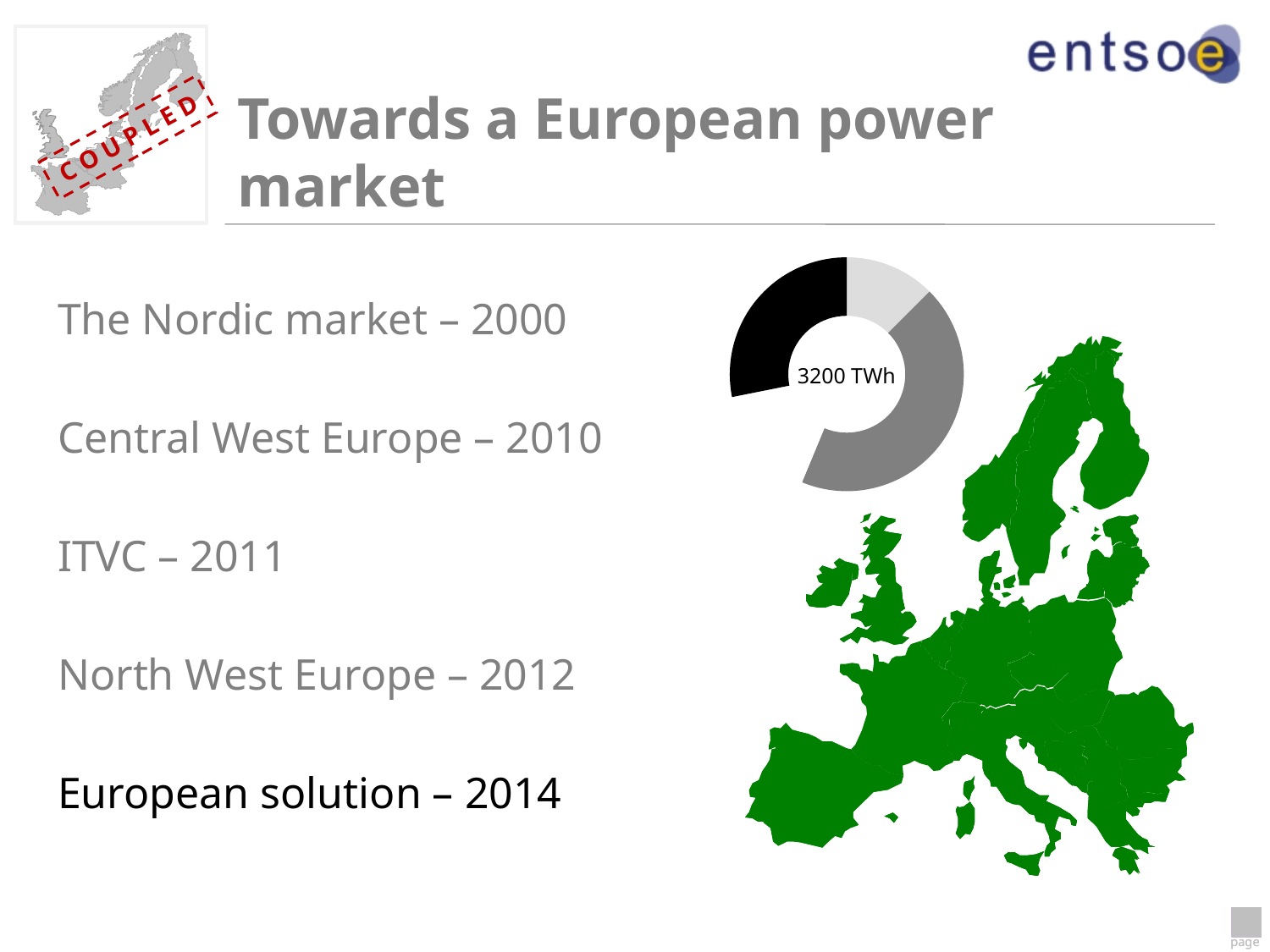
Does the donut chart display a legend? No Which slice of the donut chart is the smallest: the black, the light grey or the dark grey one? The light grey slice What kind of chart is shown on the right side of the slide next to the map? Donut (pie) chart In the donut chart, is the black slice larger or smaller than the light grey slice? Larger Which slice of the donut chart is the largest: the black, the light grey or the dark grey one? The dark grey slice What text is printed in the centre of the donut chart? 3200 TWh